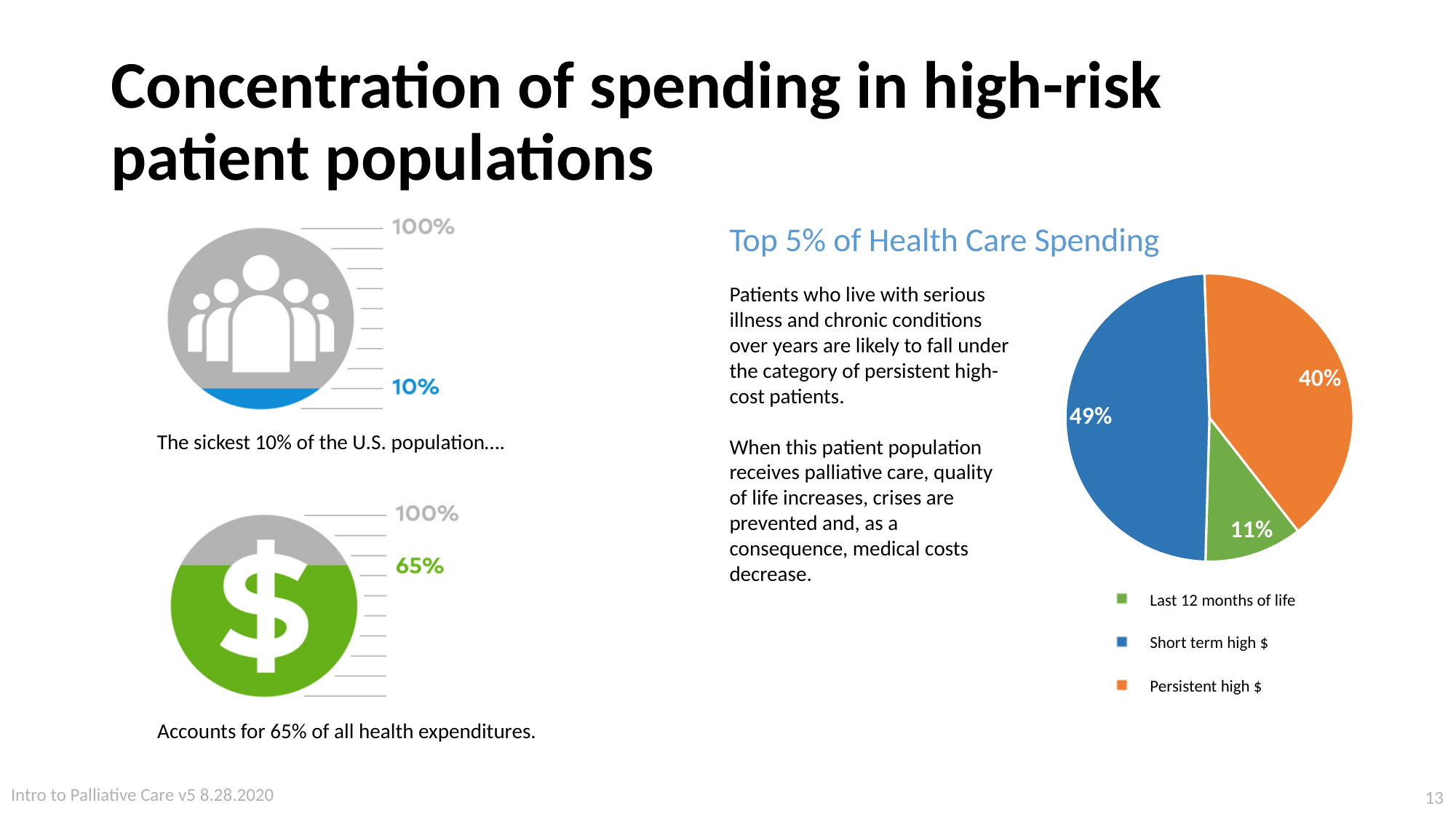
Which colour represents Persistent high $ in the pie chart? Orange What is the difference in percentage points between the Persistent high $ slice and the Last 12 months of life slice? 29 What kind of chart is shown on the right side of the slide? Pie chart What share of the pie chart does Last 12 months of life account for? 11% What is the title of the pie chart? Top 5% of Health Care Spending What is the difference in percentage points between the Short term high $ slice and the Persistent high $ slice? 9 What share of the pie chart does Persistent high $ account for? 40% Which is larger in the pie chart: Persistent high $ or Last 12 months of life? Persistent high $ Which category has the largest slice of the pie chart? Short term high $ Which category has the smallest slice of the pie chart? Last 12 months of life How many slices does the pie chart have? 3 What share of the pie chart does Short term high $ account for? 49%